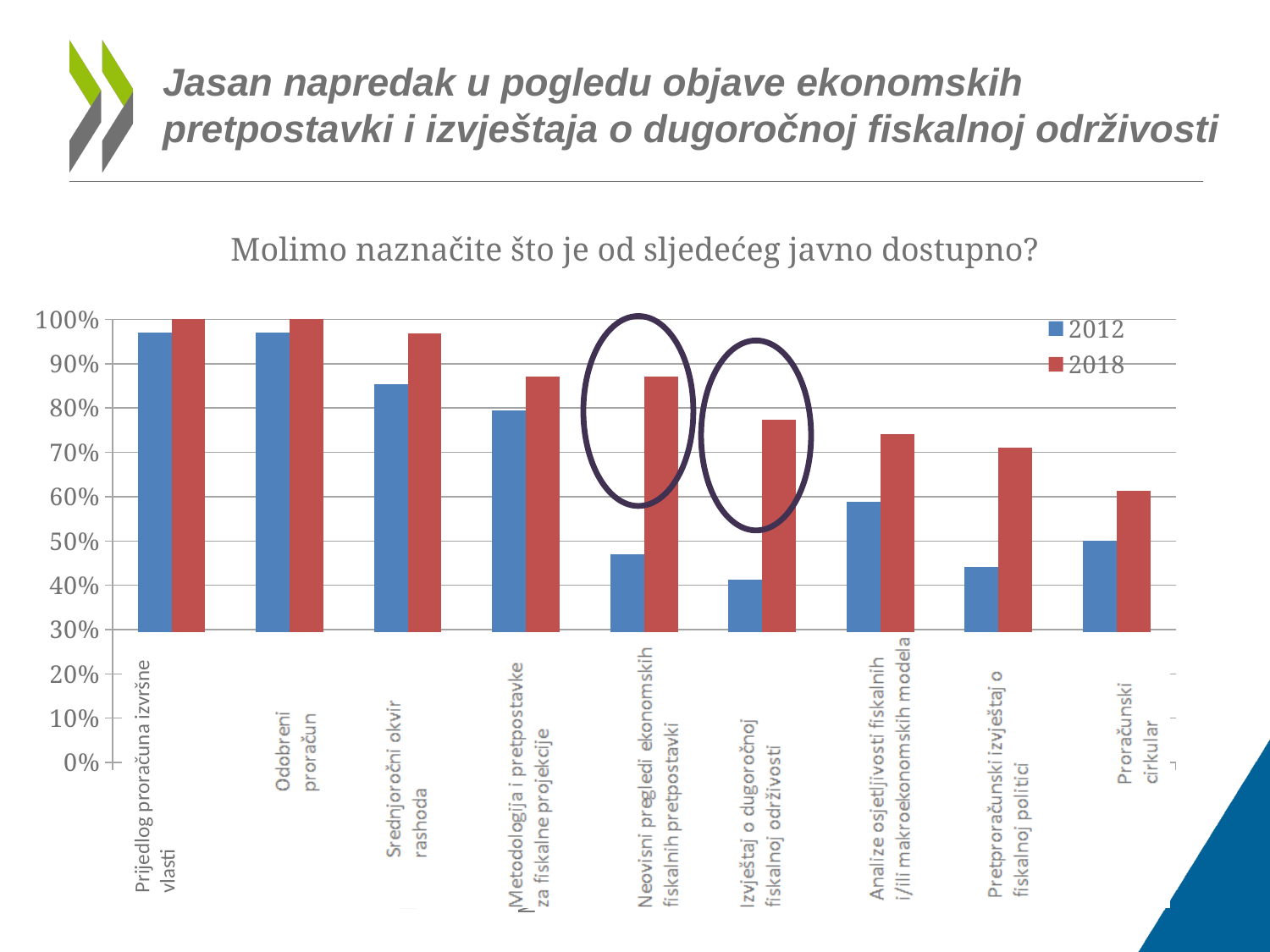
How many categories are shown on the x axis? 9 Is the 2012 value for 'Neovisni pregledi ekonomskih fiskalnih pretpostavki' greater or less than 50%? less What kind of chart is shown on the slide? bar chart What is the 2018 value for 'Prijedlog proračuna izvršne vlasti'? 100% For 'Srednjoročni okvir rashoda', which is larger: the 2012 value or the 2018 value? 2018 Do the 2018 values generally rise or fall moving from left to right along the x axis? fall Is the 2012 value for 'Pretproračunski izvještaj o fiskalnoj politici' greater or less than 50%? less Which category has the lowest 2018 value? Proračunski cirkular Is the 2018 value for 'Izvještaj o dugoročnoj fiskalnoj održivosti' greater or less than 70%? greater How many series does the legend list? 2 What is the 2018 value for 'Odobreni proračun'? 100% Which years are listed in the legend? 2012 and 2018